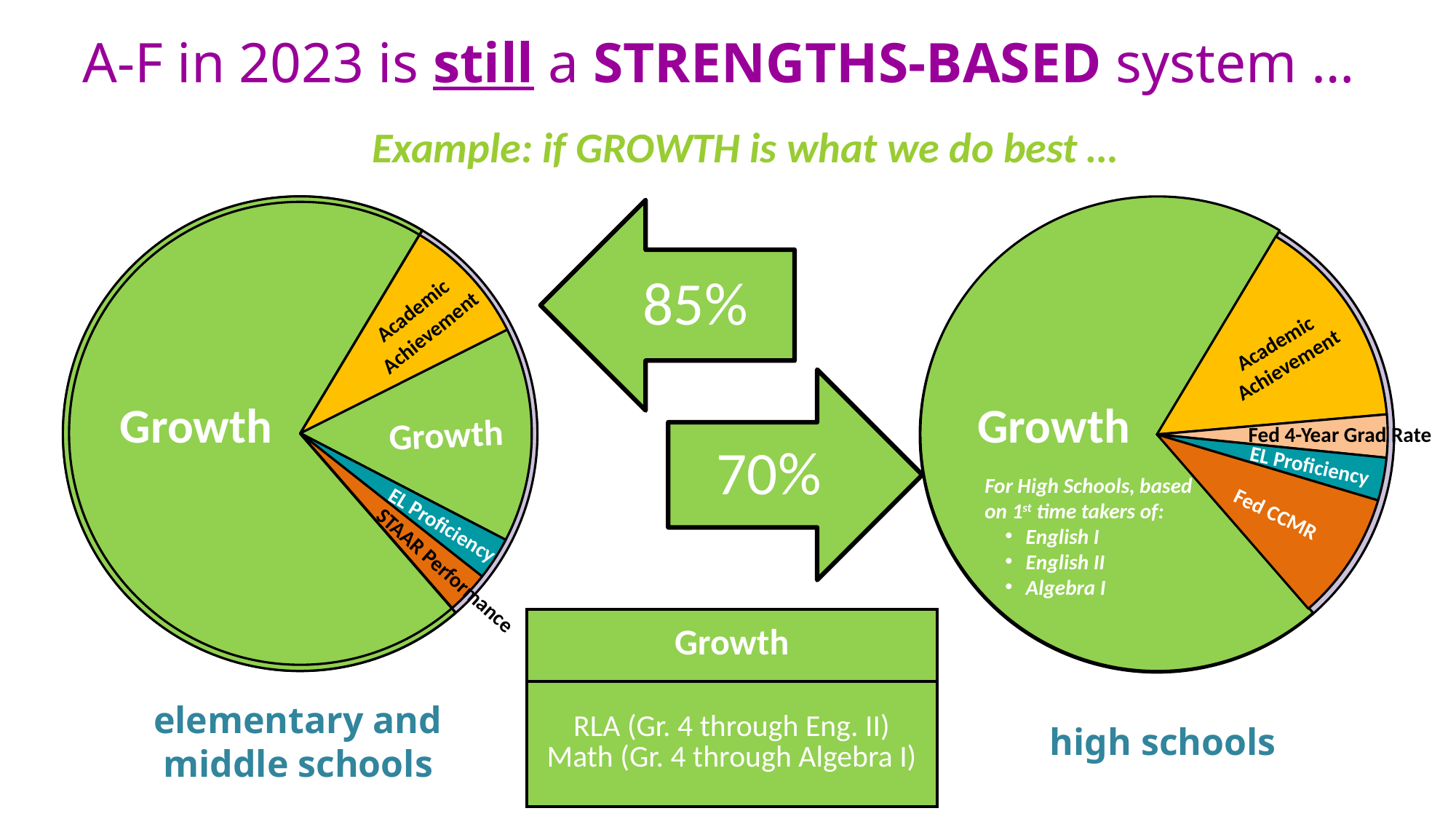
In the elementary and middle schools pie chart, which slice is the largest? Growth In the elementary and middle schools pie chart, what share does the arrow indicate for Growth? 85% In the high schools pie chart, which slice is larger: Fed CCMR or EL Proficiency? Fed CCMR In the high schools pie chart, what share does the arrow indicate for Growth? 70% Which slice appears in the high schools pie chart but not in the elementary and middle schools pie chart, labeled as a graduation rate? Fed 4-Year Grad Rate What kind of chart is used for the high schools chart? pie chart How many labeled slices does the high schools pie chart have? 5 What kind of chart is used for the elementary and middle schools chart? pie chart In the elementary and middle schools pie chart, which slice is larger: Academic Achievement or EL Proficiency? Academic Achievement In the high schools pie chart, which slice is the largest? Growth How many labeled slices does the elementary and middle schools pie chart have? 5 In the high schools pie chart, which slice is labeled in orange below EL Proficiency? Fed CCMR